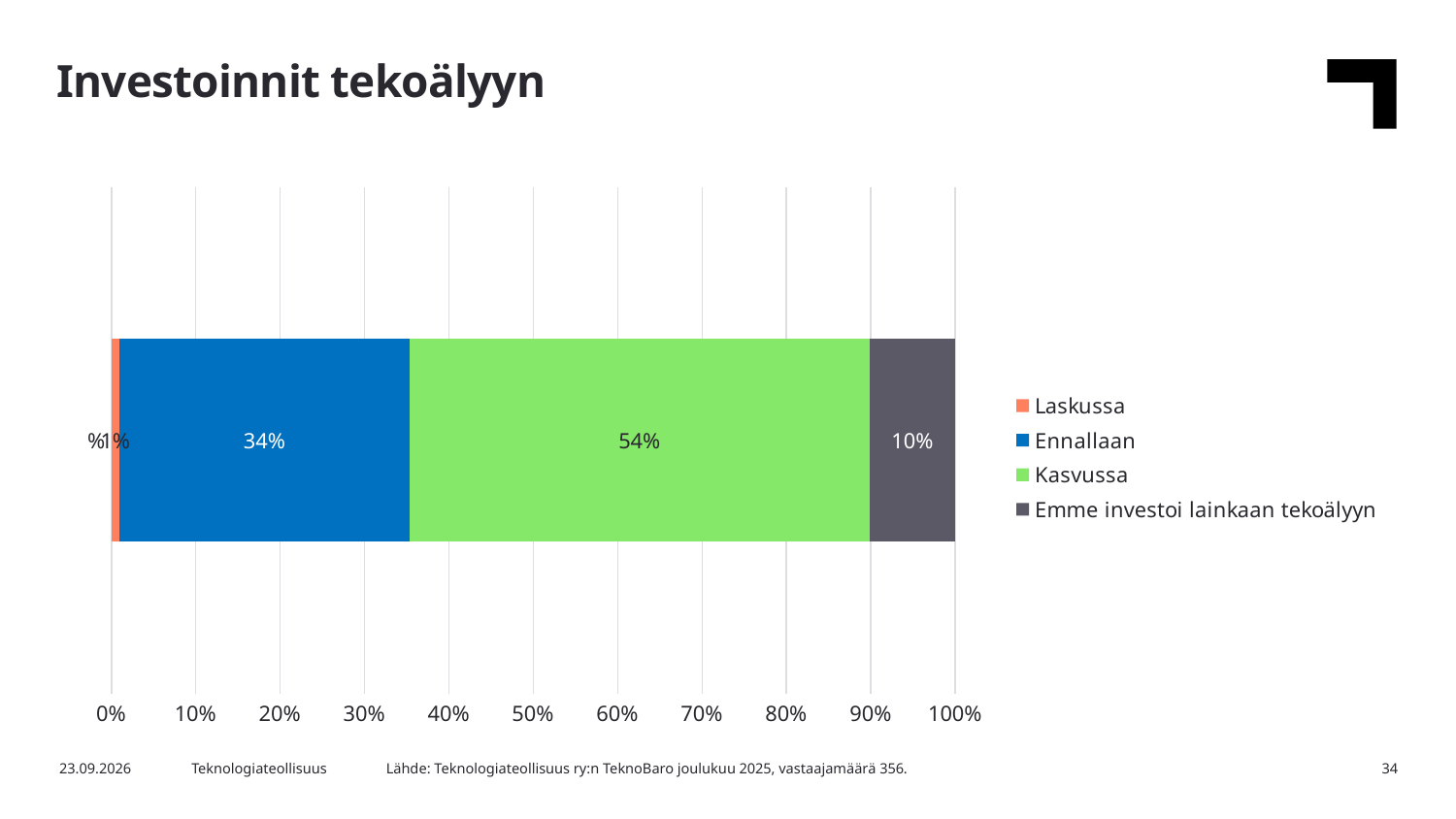
What is the value for Emme investoi lainkaan tekoälyyn? 10% Which is larger, the value for Ennallaan or the value for Emme investoi lainkaan tekoälyyn? Ennallaan How many series does the legend list? 4 What is the difference between the values for Kasvussa and Ennallaan? 20% What is the value for Kasvussa? 54% What is the difference between the values for Ennallaan and Emme investoi lainkaan tekoälyyn? 24% Is the value for Ennallaan greater or less than 30%? greater Which series has the largest share of the bar? Kasvussa What kind of chart is shown on the slide? Bar chart What is the value for Ennallaan? 34% Which series has the smallest share of the bar? Laskussa What is the title of the chart? Investoinnit tekoälyyn